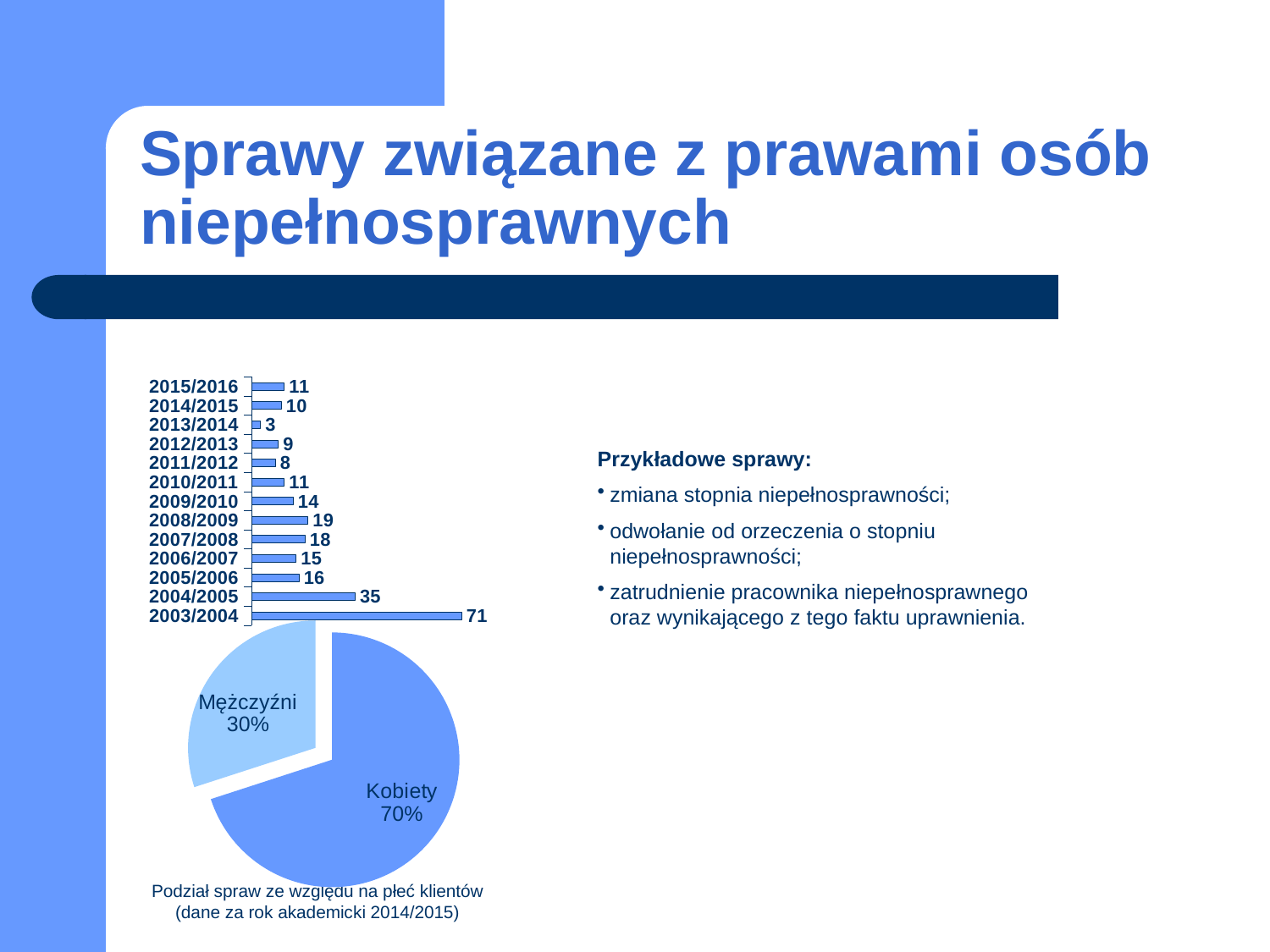
In the bar chart at the top left, what is the value for 2003/2004? 71 In the pie chart titled 'Podział spraw ze względu na płeć klientów', what share is Kobiety? 70% How many slices does the pie chart titled 'Podział spraw ze względu na płeć klientów' have? 2 In the bar chart at the top left, which academic year has the highest value? 2003/2004 In the bar chart at the top left, which academic year has the lowest value? 2013/2014 In the bar chart at the top left, what is the value for 2008/2009? 19 In the bar chart at the top left, what is the value for 2013/2014? 3 In the pie chart titled 'Podział spraw ze względu na płeć klientów', what share is Mężczyźni? 30% In the bar chart at the top left, which is larger, the value for 2009/2010 or the value for 2012/2013? 2009/2010 In the bar chart at the top left, what is the difference between the values for 2003/2004 and 2004/2005? 36 What kind of chart is the chart at the top left of the slide? bar chart How many academic years are shown in the bar chart at the top left? 13